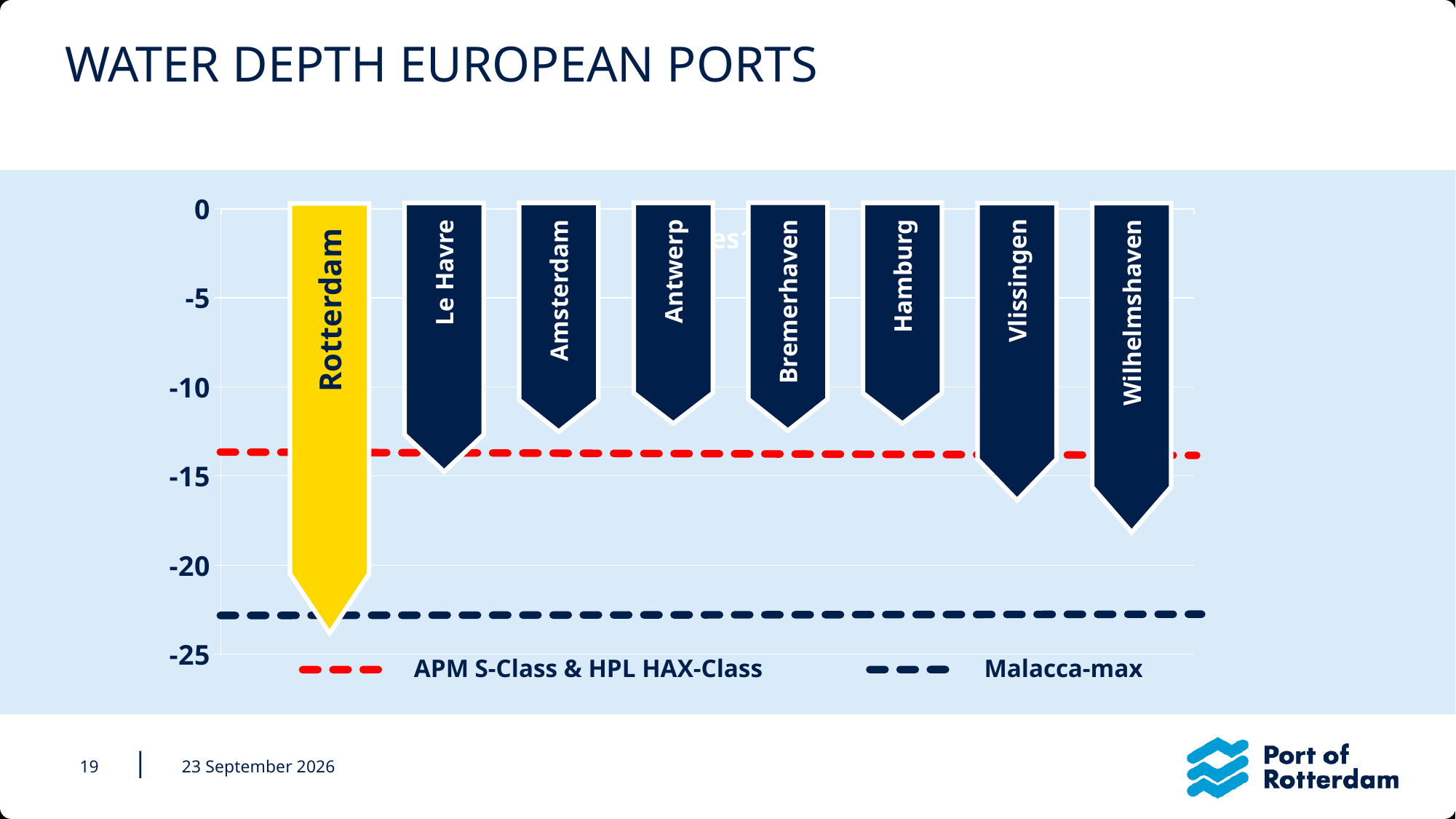
Is the value for Amsterdam greater or less than -15? greater How many ports are shown in the chart? 8 What kind of chart is shown on the slide? bar chart How many entries does the legend list? 2 Which port has the deeper water, Rotterdam or Le Havre? Rotterdam Is the value for Hamburg greater or less than -10? less Is the value for Wilhelmshaven greater or less than -15? less Which port has the greatest water depth (the lowest value) in the chart? Rotterdam What is the title of the chart on the slide? WATER DEPTH EUROPEAN PORTS Which port has the deeper water, Wilhelmshaven or Vlissingen? Wilhelmshaven Which port's bar is highlighted in yellow? Rotterdam